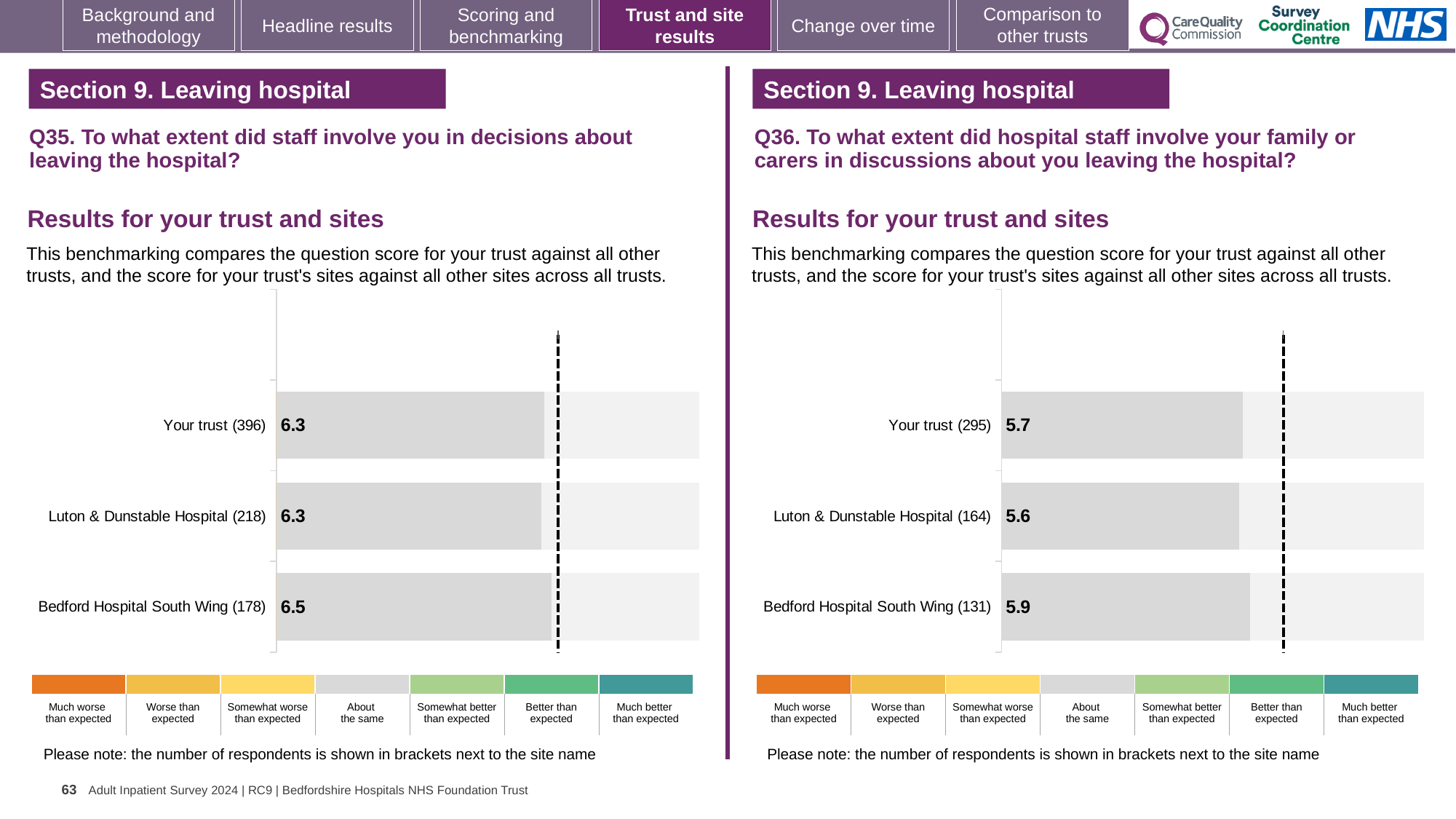
In the Q36 chart on the right, how many respondents are shown in brackets for Your trust? 295 In the Q36 chart on the right, which site or trust has the highest score? Bedford Hospital South Wing In the Q35 chart on the left, what is the difference between the score for Bedford Hospital South Wing and the score for Luton & Dunstable Hospital? 0.2 In the Q36 chart on the right, what is the difference between the score for Bedford Hospital South Wing and the score for Your trust? 0.2 In the Q35 chart on the left, what is the score for Your trust? 6.3 In the Q36 chart on the right, what is the score for Luton & Dunstable Hospital? 5.6 How many bars are shown in the Q35 chart on the left? 3 In the Q36 chart on the right, which site or trust has the lowest score? Luton & Dunstable Hospital In the Q35 chart on the left, what is the score for Bedford Hospital South Wing? 6.5 What type of chart is used for the Q36 results on the right? Bar chart In the Q36 chart on the right, what is the score for Your trust? 5.7 In the Q35 chart on the left, which has the higher score: Bedford Hospital South Wing or Your trust? Bedford Hospital South Wing